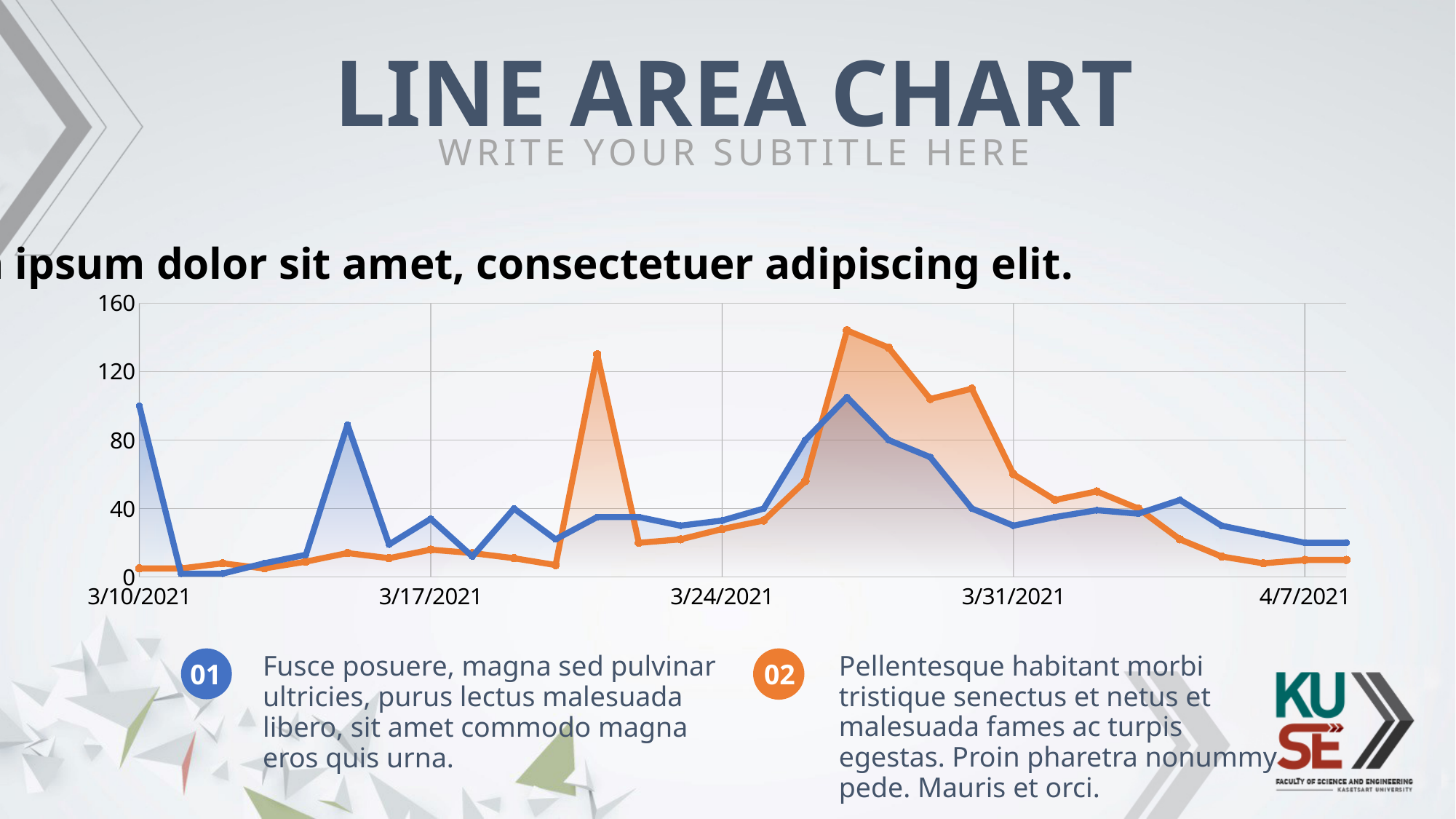
Is the peak value of the orange line greater or less than 120? greater What kind of chart is shown on the slide? line chart How many date labels are shown on the x axis? 5 What is the title of the slide containing the chart? LINE AREA CHART Is the peak value of the blue line greater or less than 80? greater At 4/7/2021, which line has the higher value, the blue line or the orange line? blue line What is the highest value shown on the y axis? 160 Does the blue line rise or fall between 3/10/2021 and the next data point? fall At 3/31/2021, which line has the higher value, the blue line or the orange line? orange line Is the value of the blue line at 3/10/2021 greater or less than 80? greater How many lines (series) are plotted on the chart? 2